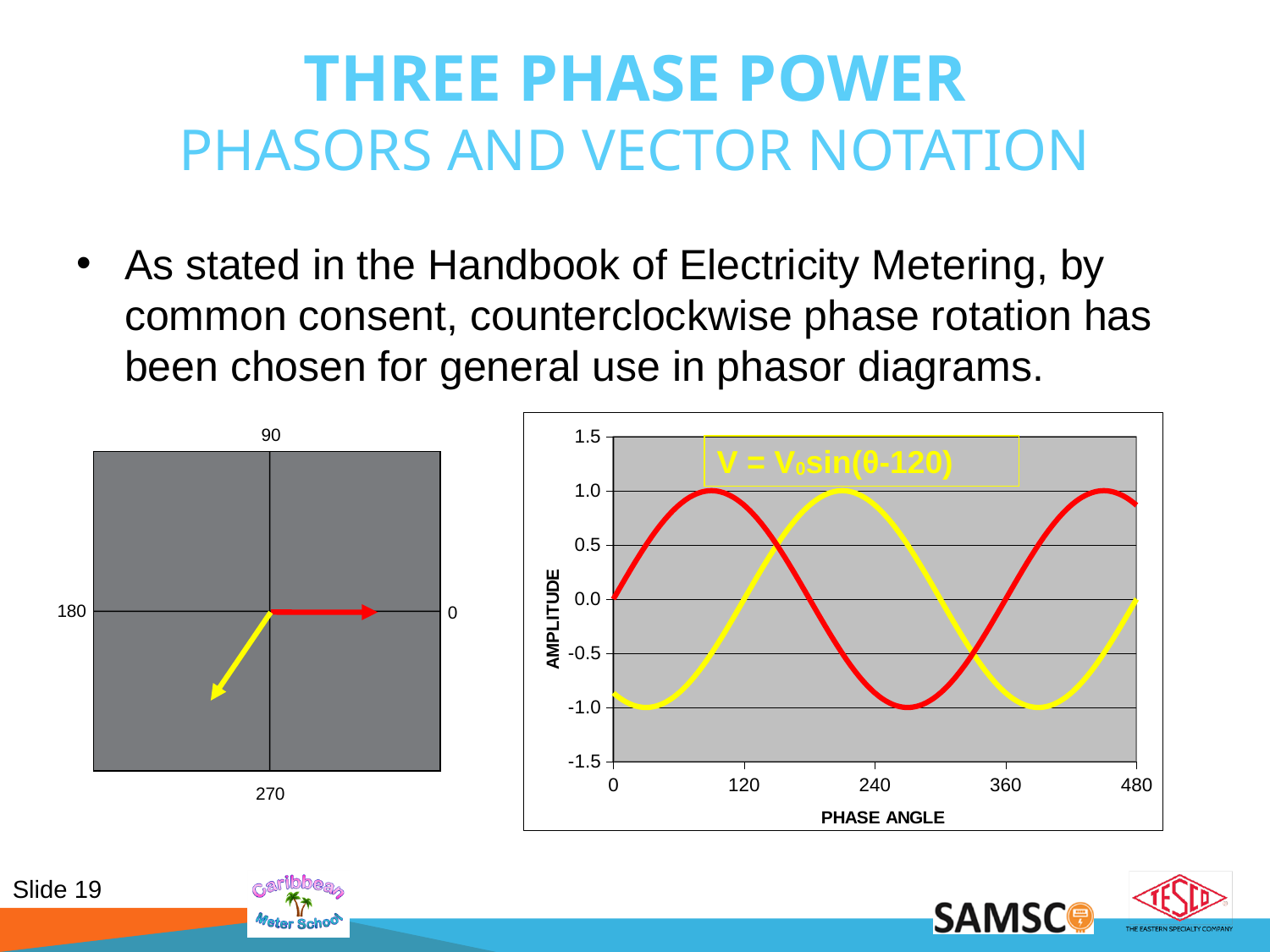
In the chart on the right, what is the lowest amplitude reached by the yellow line? -1.0 In the chart on the right, is the amplitude of the red line at phase angle 120 greater or less than 0.5? greater In the chart on the right, how many tick labels are shown on the phase angle axis? 5 In the chart on the right, how many lines are plotted? 2 In the chart on the right, is the amplitude of the yellow line at phase angle 0 greater or less than -0.5? less In the chart on the right, what is the title of the vertical axis? AMPLITUDE In the chart on the right, what is the amplitude of the red line at phase angle 0? 0.0 What kind of chart is the chart on the right of the slide? line chart In the chart on the right, what is the amplitude of the yellow line at phase angle 120? 0.0 In the chart on the right, what is the title of the horizontal axis? PHASE ANGLE In the chart on the right, what is the highest amplitude reached by the red line? 1.0 In the chart on the right, at phase angle 240, which line has the higher amplitude, red or yellow? yellow